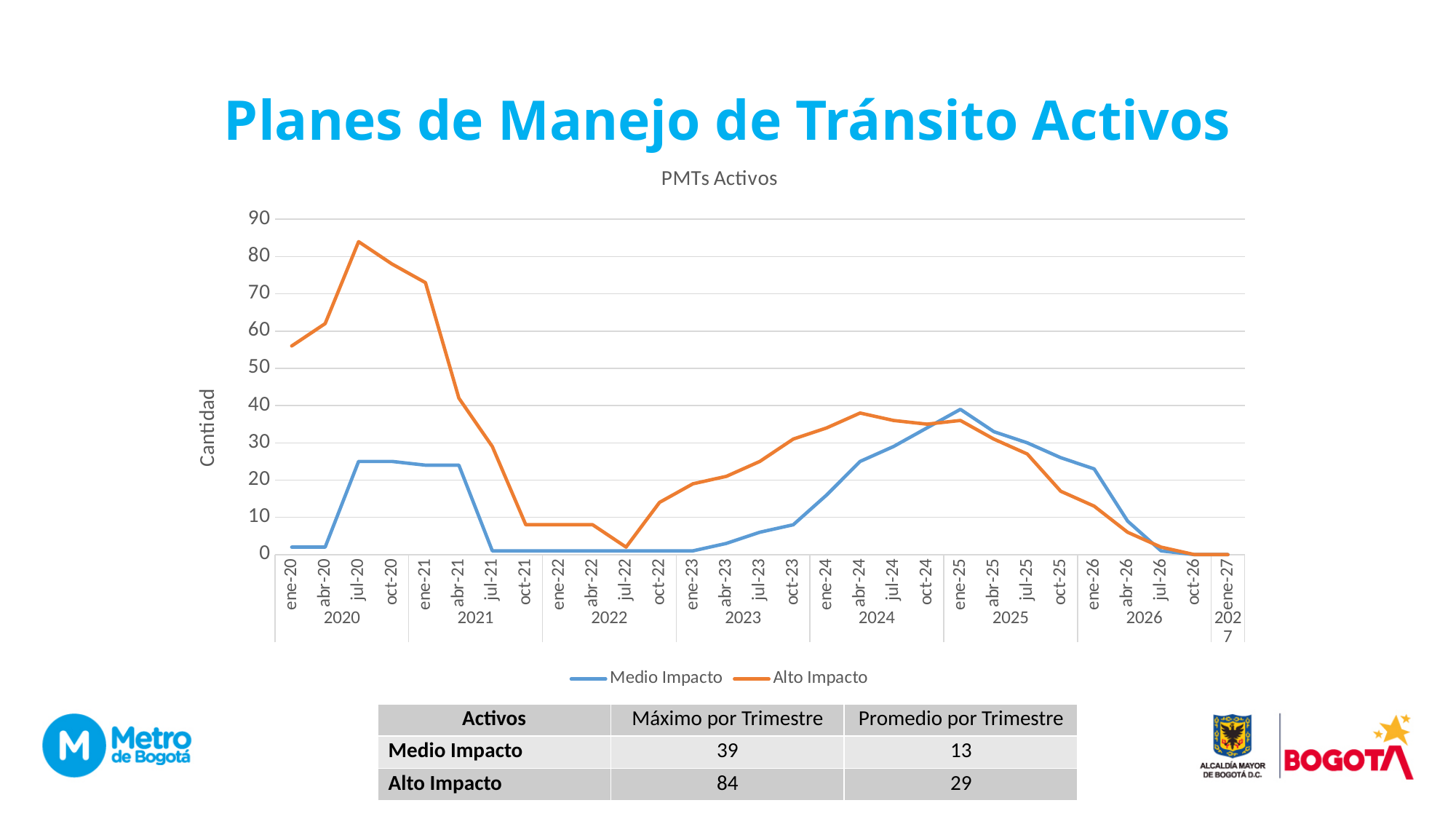
Is the value for Medio Impacto in jul-20 greater or less than 30? less What is the maximum quarterly value of the Alto Impacto series, as given in the table? 84 Which series has the higher value in ene-26, Medio Impacto or Alto Impacto? Medio Impacto In which quarter does the Alto Impacto series reach its highest value? jul-20 In which quarter does the Medio Impacto series reach its highest value? ene-25 How many series does the legend of the PMTs Activos chart list? 2 What are the names of the two series in the PMTs Activos chart? Medio Impacto and Alto Impacto What is the maximum quarterly value of the Medio Impacto series, as given in the table? 39 What is the label of the vertical axis of the PMTs Activos chart? Cantidad How many quarterly points are plotted along the x axis of the PMTs Activos chart? 29 What kind of chart is shown on the slide? Line chart Does the Alto Impacto series rise or fall between jul-20 and oct-21? Fall